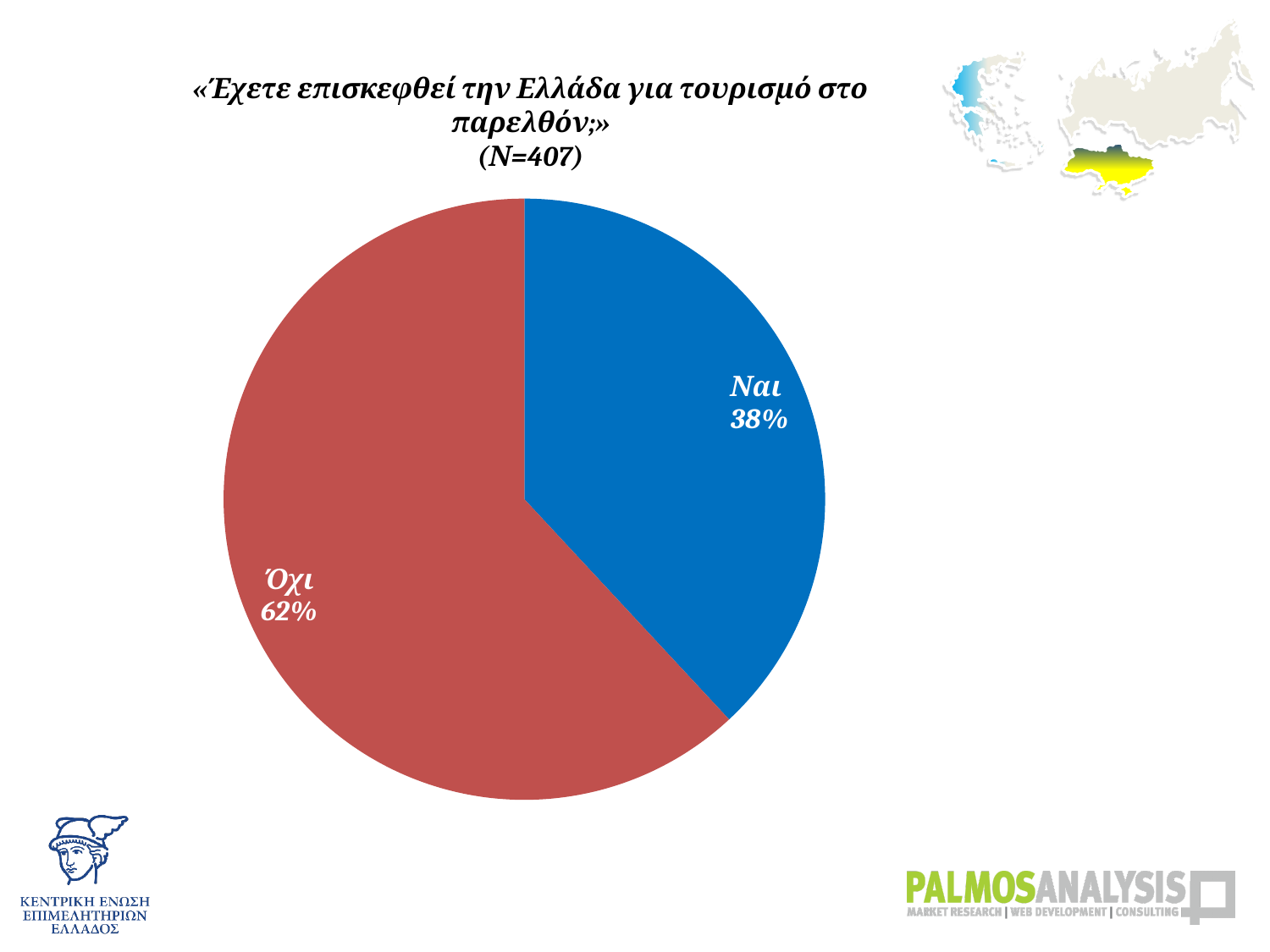
What percentage of respondents answered Όχι? 62% What is the sample size (N) stated in the chart title? 407 Which response has the smallest share of the pie? Ναι Which is larger, the share for Ναι or the share for Όχι? Όχι Which response has the largest share of the pie? Όχι Is the share for Ναι greater or less than 50%? less How many slices does the pie chart have? 2 What is the difference in percentage points between Όχι and Ναι? 24 What kind of chart is shown on the slide? pie chart What percentage of respondents answered Ναι? 38% What colour is the Ναι slice? blue